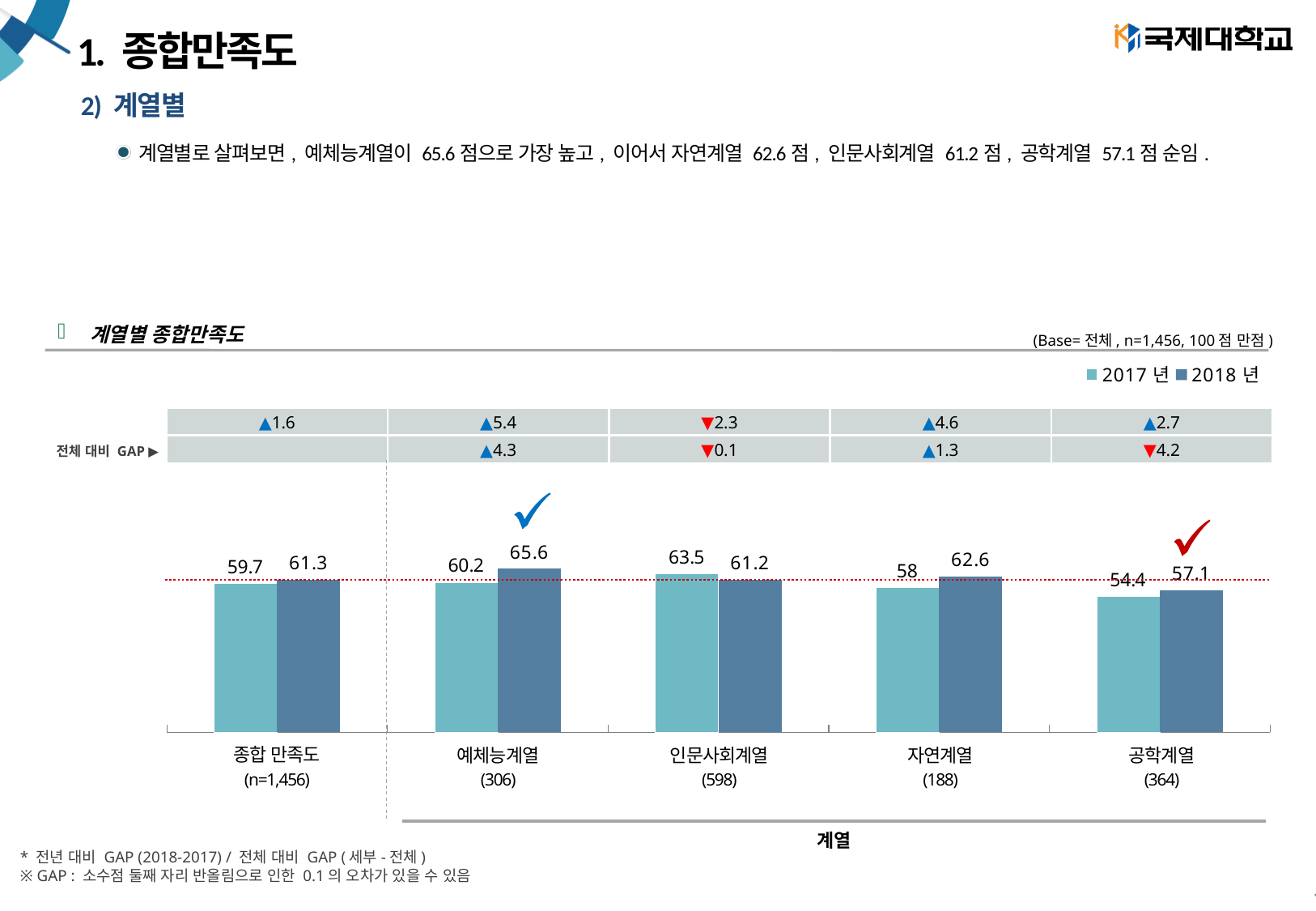
What kind of chart is shown on the slide? bar chart Which category has the lowest 2017년 value? 공학계열 Which category has the highest 2018년 value? 예체능계열 What is the difference between the 2018년 values for 자연계열 and 공학계열? 5.5 How many series does the legend list? 2 What is the title of the chart? 계열별 종합만족도 What is the 2018년 value for 예체능계열? 65.6 What is the 2017년 value for 자연계열? 58 Which is larger for 인문사회계열, the 2017년 value or the 2018년 value? 2017년 What is the difference between the 2018년 and 2017년 values for 예체능계열? 5.4 What is the 2017년 value for 공학계열? 54.4 How many categories are shown on the x axis of the chart? 5